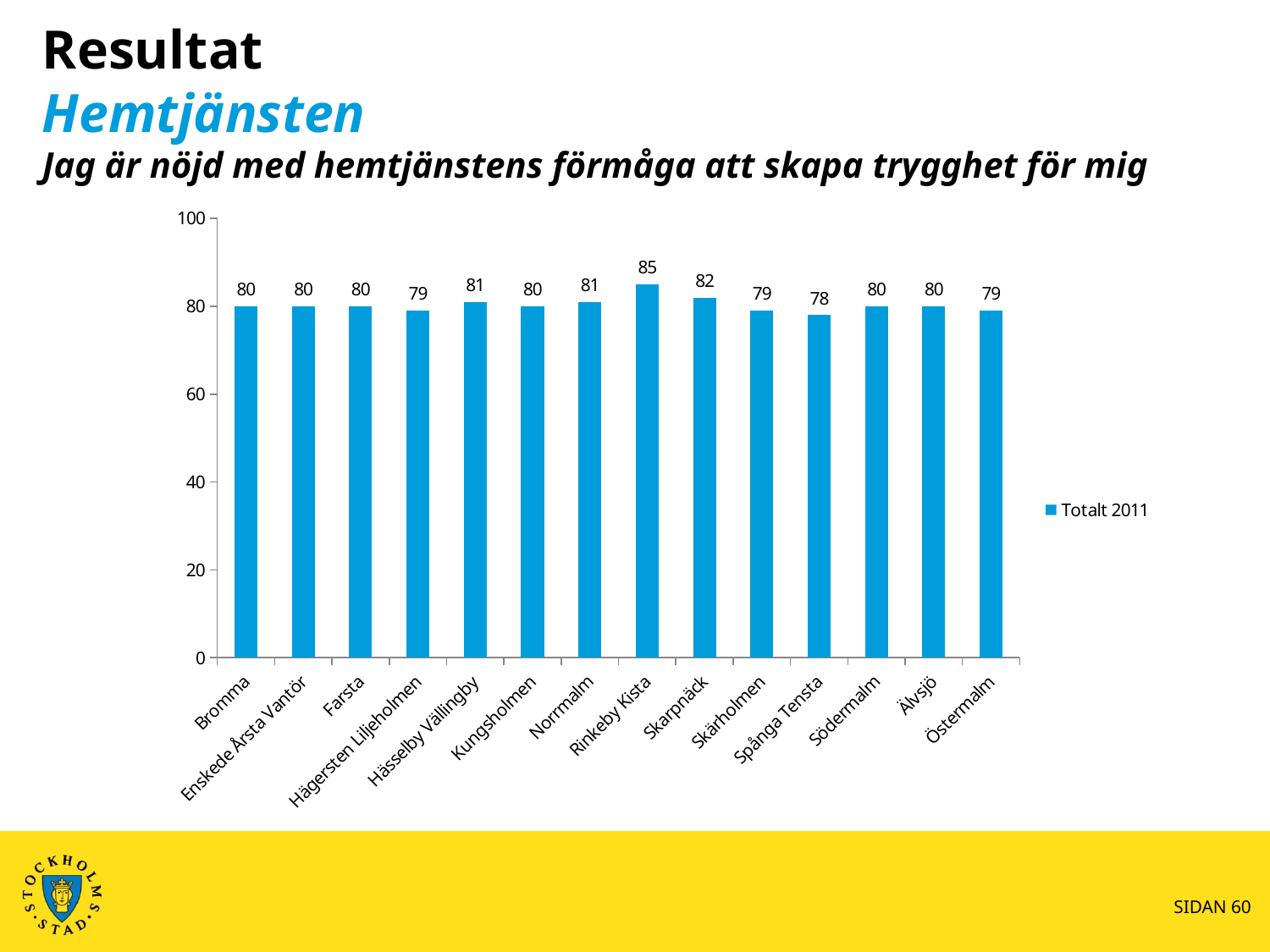
Which category has the lowest value? Spånga Tensta What is the value for Hässelby Vällingby? 81 What is the difference between the values for Rinkeby Kista and Spånga Tensta? 7 What is the value for Spånga Tensta? 78 What is the value for Skarpnäck? 82 What is the value for Rinkeby Kista? 85 Is the value for Norrmalm greater or less than 60? greater Which is larger, the value for Skarpnäck or the value for Östermalm? Skarpnäck How many categories are shown on the x axis? 14 What kind of chart is shown on the slide? bar chart Which category has the highest value? Rinkeby Kista How many series does the legend list? 1